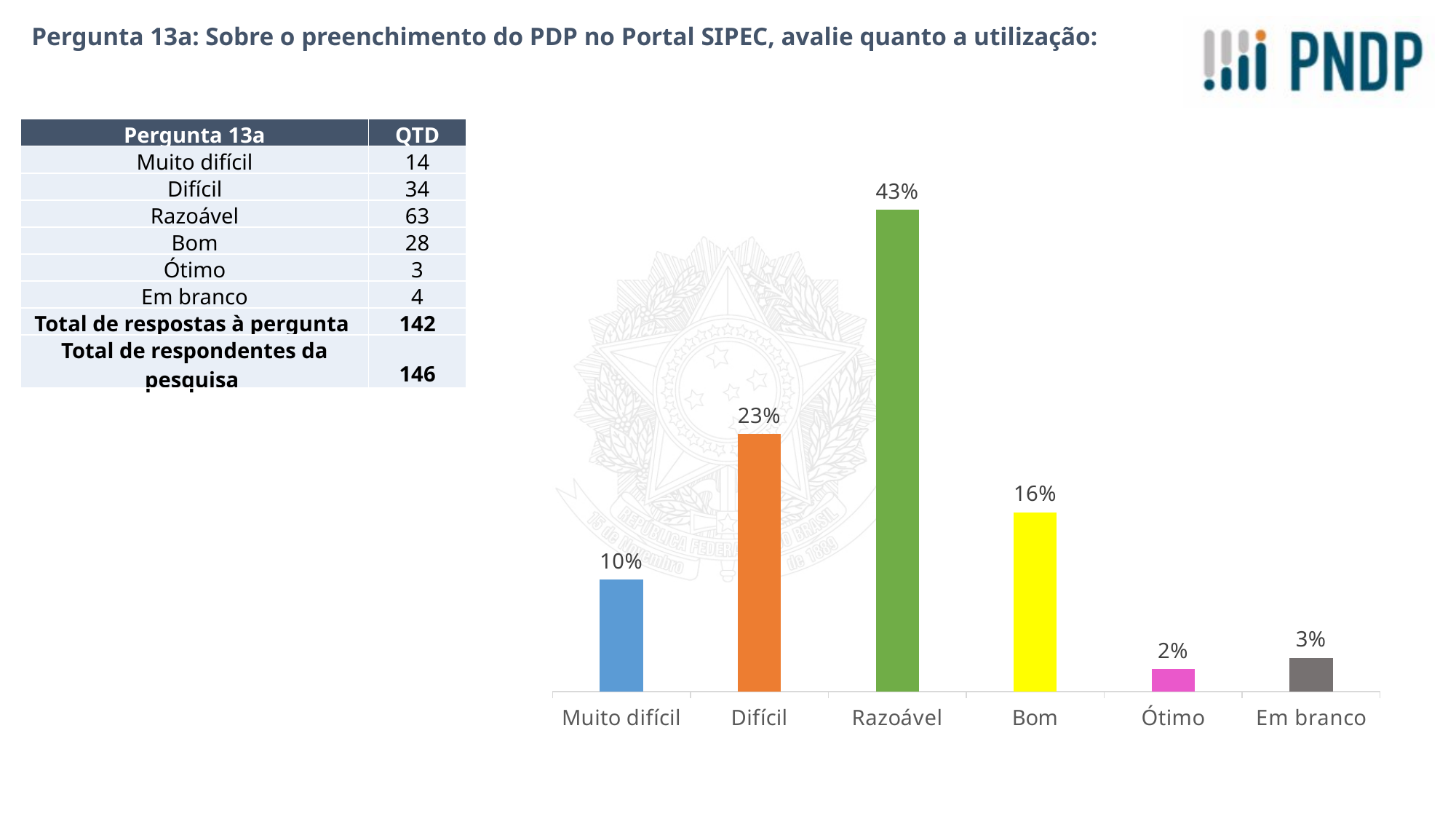
What is the difference in percentage points between Bom and Ótimo in the bar chart? 14 What kind of chart is shown on the slide? Bar chart What percentage is shown for Bom in the bar chart? 16% What colour is the bar for Razoável? Green What percentage is shown for Razoável in the bar chart? 43% How many categories are shown on the x axis of the bar chart? 6 What is the difference in percentage points between Razoável and Difícil in the bar chart? 20 What percentage is shown for Em branco in the bar chart? 3% Which is larger in the bar chart, Difícil or Bom? Difícil Which category has the highest value in the bar chart? Razoável What percentage is shown for Muito difícil in the bar chart? 10% Which category has the lowest value in the bar chart? Ótimo